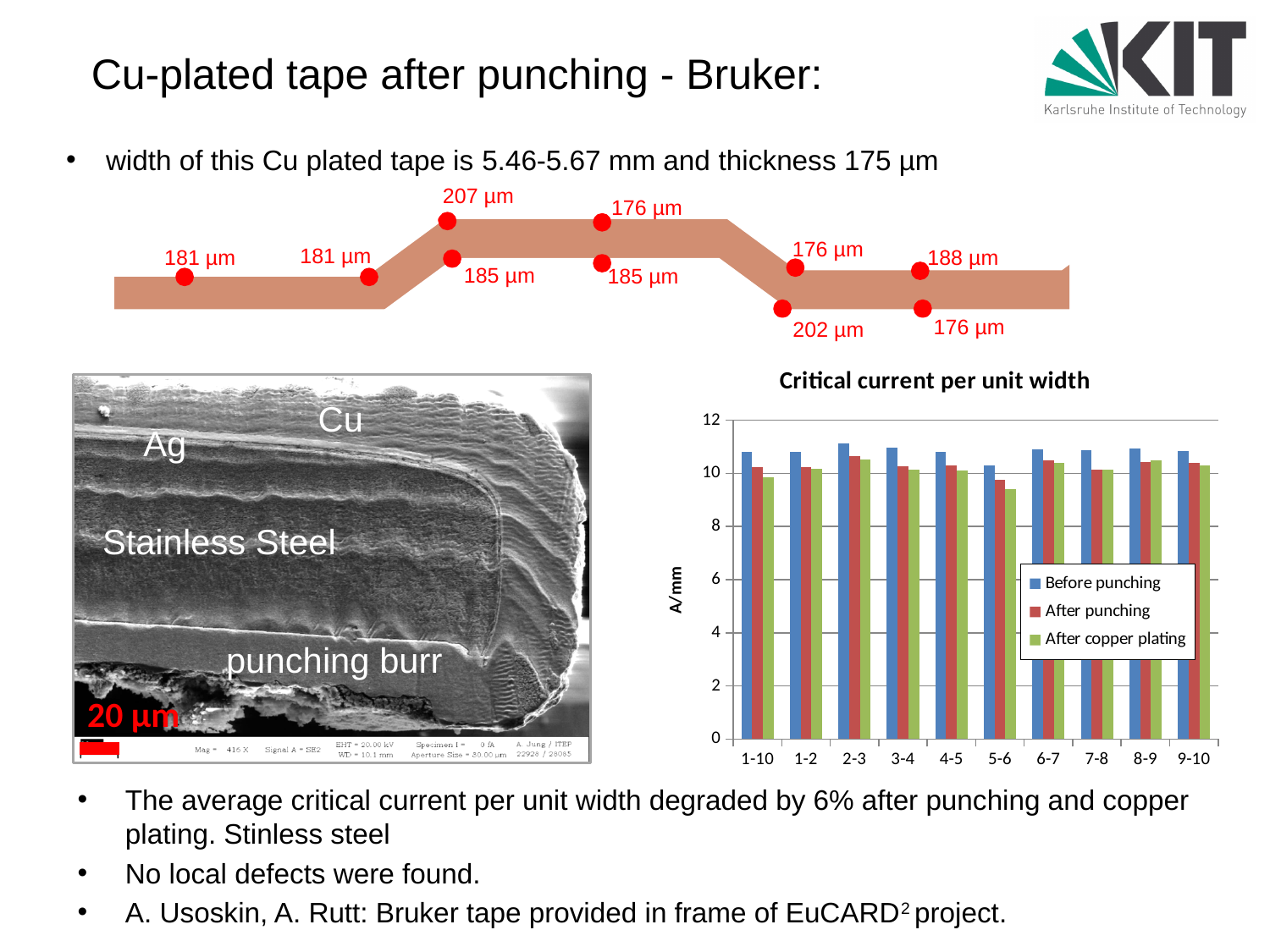
In the 'Critical current per unit width' chart, is the 'After copper plating' value for 5-6 greater or less than 10? less In the 'Critical current per unit width' chart, is the 'After copper plating' value for 9-10 greater or less than 8? greater What kind of chart is shown under the title 'Critical current per unit width'? bar chart Which series in the 'Critical current per unit width' chart is shown in green? After copper plating How many series does the legend of the 'Critical current per unit width' chart list? 3 In the 'Critical current per unit width' chart, which is larger for category 5-6: 'Before punching' or 'After copper plating'? Before punching In the 'Critical current per unit width' chart, is the 'Before punching' value for 2-3 greater or less than 10? greater In the 'Critical current per unit width' chart, for which category is the 'After copper plating' value lowest? 5-6 In the 'Critical current per unit width' chart, which is larger for category 1-10: 'Before punching' or 'After copper plating'? Before punching How many categories are shown on the x axis of the 'Critical current per unit width' chart? 10 What is the y-axis label of the 'Critical current per unit width' chart? A/mm